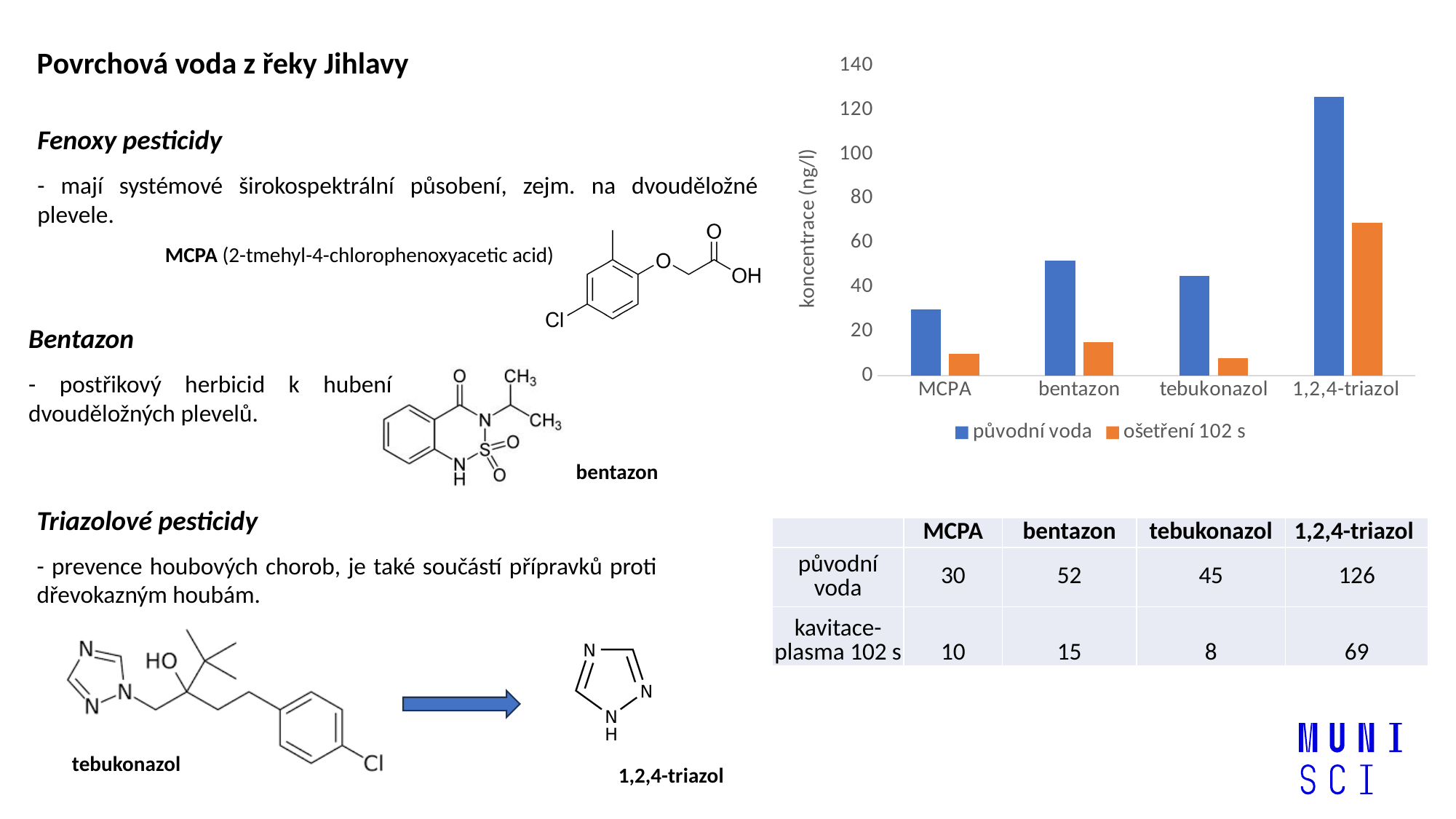
What is the label of the y axis of the chart? koncentrace (ng/l) Which category has the highest value for the 'původní voda' series? 1,2,4-triazol Which series is shown in orange in the chart? ošetření 102 s What is the 'původní voda' concentration for 1,2,4-triazol? 126 How many categories are shown on the x axis of the chart? 4 What is the 'ošetření 102 s' concentration for bentazon? 15 What is the difference between the 'původní voda' and 'ošetření 102 s' values for MCPA? 20 What kind of chart is shown on the slide? bar chart Which category has the lowest value for the 'ošetření 102 s' series? tebukonazol For the 'původní voda' series, which is larger: bentazon or tebukonazol? bentazon How many series does the chart legend list? 2 Is the 'ošetření 102 s' value for 1,2,4-triazol greater or less than 60? greater